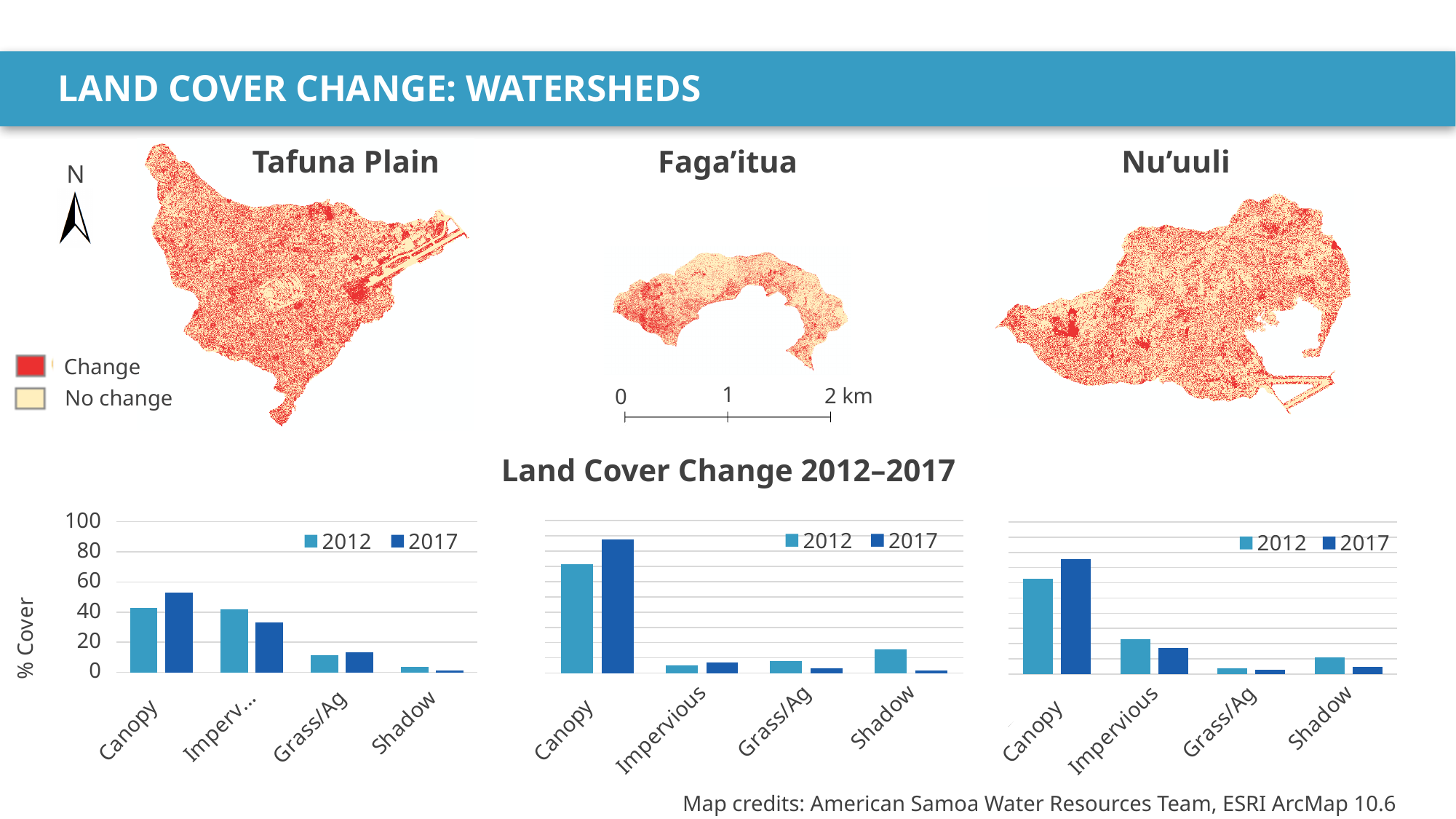
How many series does the legend of the Faga'itua chart list? 2 In the Tafuna Plain chart, is the 2017 value for Impervious greater or less than 40? less How many land cover categories are shown on the x axis of the Nu'uuli chart? 4 In the Faga'itua chart, is the 2012 value for Canopy greater or less than 60? greater In the Faga'itua chart, is the 2017 value for Canopy greater or less than 80? greater What is the label on the y axis of the bar charts? % Cover In the Nu'uuli chart, which is larger for Canopy: the 2012 value or the 2017 value? 2017 In the Nu'uuli chart, which category has the highest 2017 value? Canopy In the Tafuna Plain chart, which category has the lowest 2012 value? Shadow In the Tafuna Plain chart, which is larger for Impervious: the 2012 value or the 2017 value? 2012 In the Faga'itua chart, which is larger for Shadow: the 2012 value or the 2017 value? 2012 What kind of chart is the Tafuna Plain chart at the bottom left of the slide? bar chart